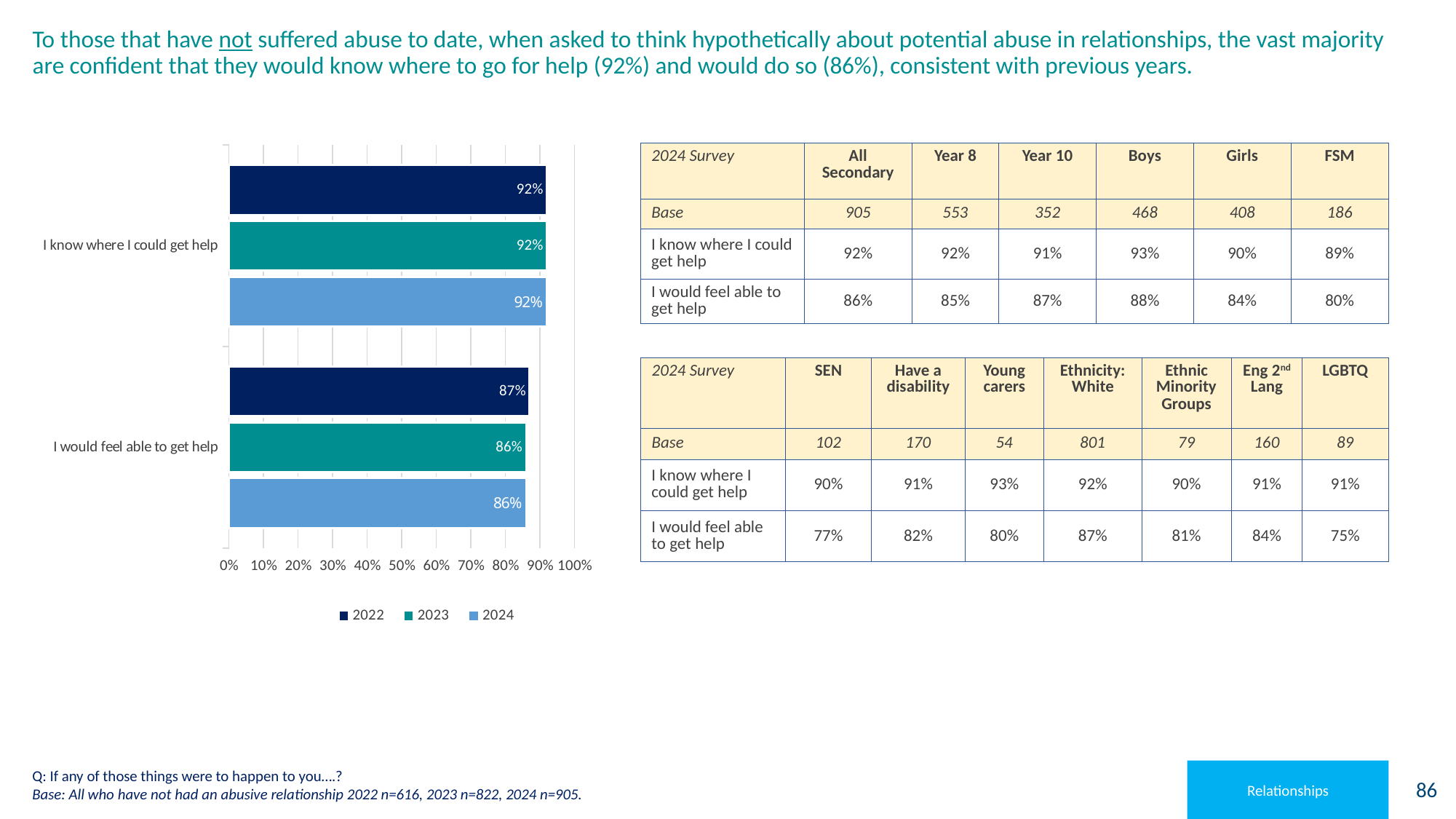
How many series does the chart legend list? 3 What is the 2023 value for 'I would feel able to get help'? 86% What is the 2024 value for 'I know where I could get help'? 92% Is the 2023 value for 'I would feel able to get help' greater or less than 80%? greater Which category has the lowest value in the 2024 series? I would feel able to get help Which is larger for 2022: 'I know where I could get help' or 'I would feel able to get help'? I know where I could get help Which years are listed in the chart legend? 2022, 2023, 2024 What is the 2022 value for 'I know where I could get help'? 92% What is the 2022 value for 'I would feel able to get help'? 87% What type of chart is shown on the slide? bar chart How many categories are shown on the chart? 2 What is the difference between the 2024 values for 'I know where I could get help' and 'I would feel able to get help'? 6%